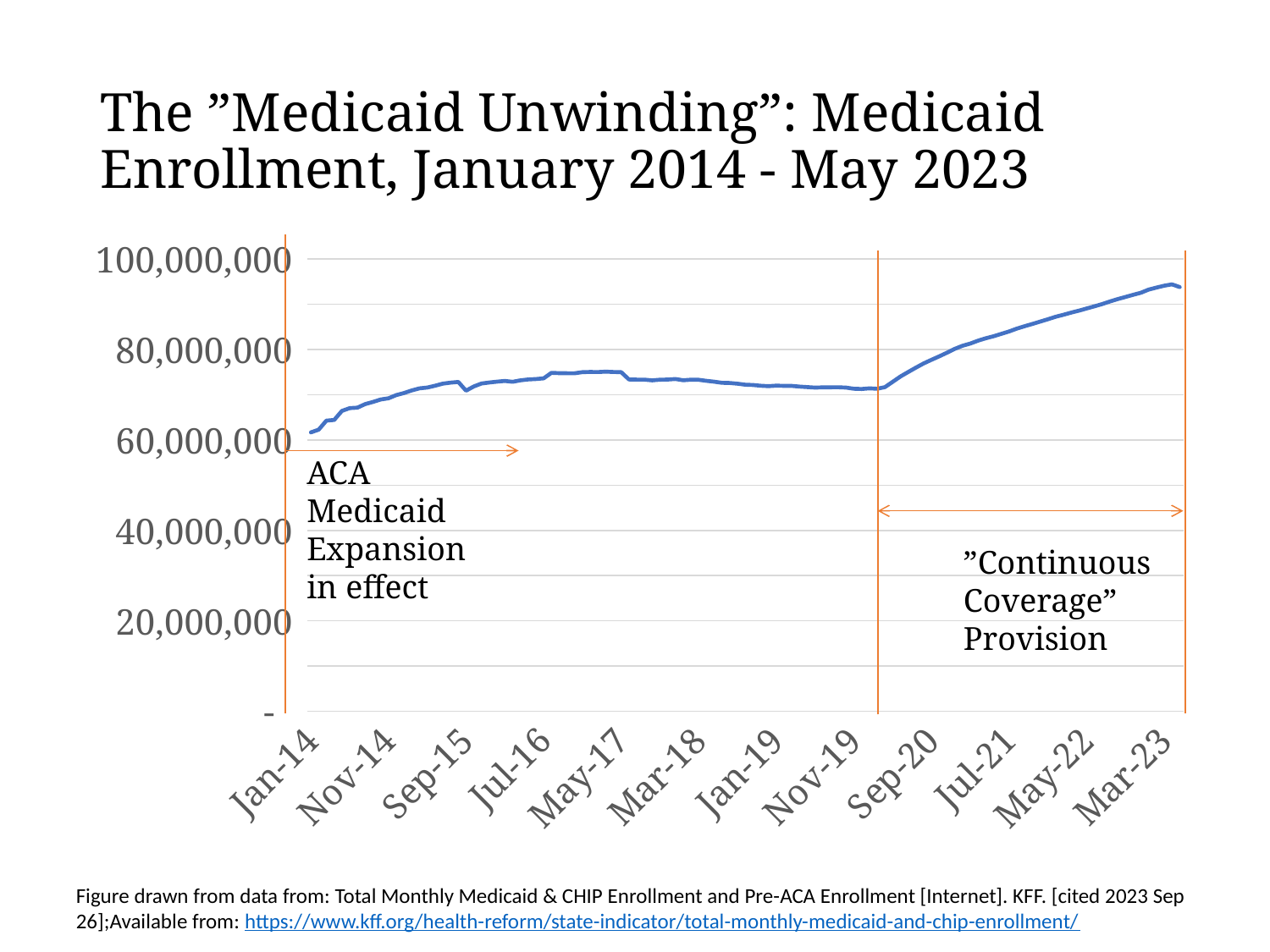
Which of the labeled x-axis dates has the lowest enrollment value? Jan-14 Is the enrollment value at May-22 greater or less than 80,000,000? greater Which has the larger enrollment value, Nov-19 or Mar-23? Mar-23 Which of the labeled x-axis dates has the highest enrollment value? Mar-23 What kind of chart is shown on the slide? line chart What is the title of the chart on the slide? The "Medicaid Unwinding": Medicaid Enrollment, January 2014 - May 2023 Is the enrollment value at Mar-23 greater or less than 80,000,000? greater What provision is labeled in the annotated region on the right side of the chart? "Continuous Coverage" Provision How many date labels are shown along the x axis of the chart? 12 Is the enrollment value at Jan-14 greater or less than 80,000,000? less Does enrollment rise or fall between Sep-20 and Mar-23? rise